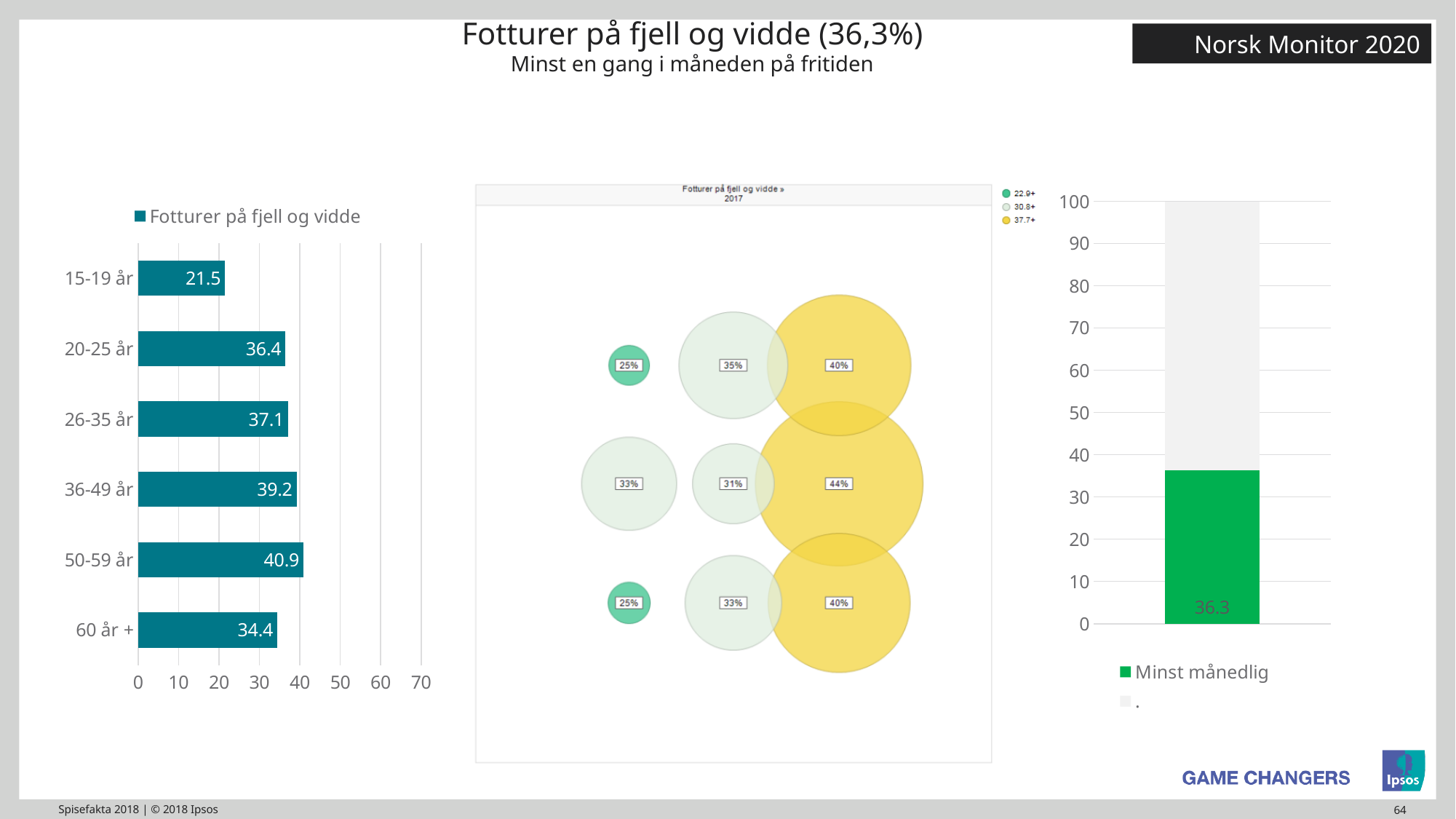
In the right chart, is the value for Minst månedlig greater or less than 50? less How many age groups are shown in the left bar chart? 6 In the middle bubble chart, what is the highest percentage shown in any bubble? 44% How many entries does the legend of the middle bubble chart list? 3 In the left bar chart, what is the difference between the values for 50-59 år and 60 år +? 6.5 What kind of chart is the chart on the left of the slide? bar chart In the right chart, what is the value for Minst månedlig? 36.3 In the left bar chart, what is the value for 15-19 år? 21.5 In the left bar chart, which age group has the lowest value? 15-19 år In the left bar chart, which is larger: the value for 20-25 år or the value for 36-49 år? 36-49 år In the left bar chart, what is the value for 50-59 år? 40.9 In the left bar chart, which age group has the highest value? 50-59 år